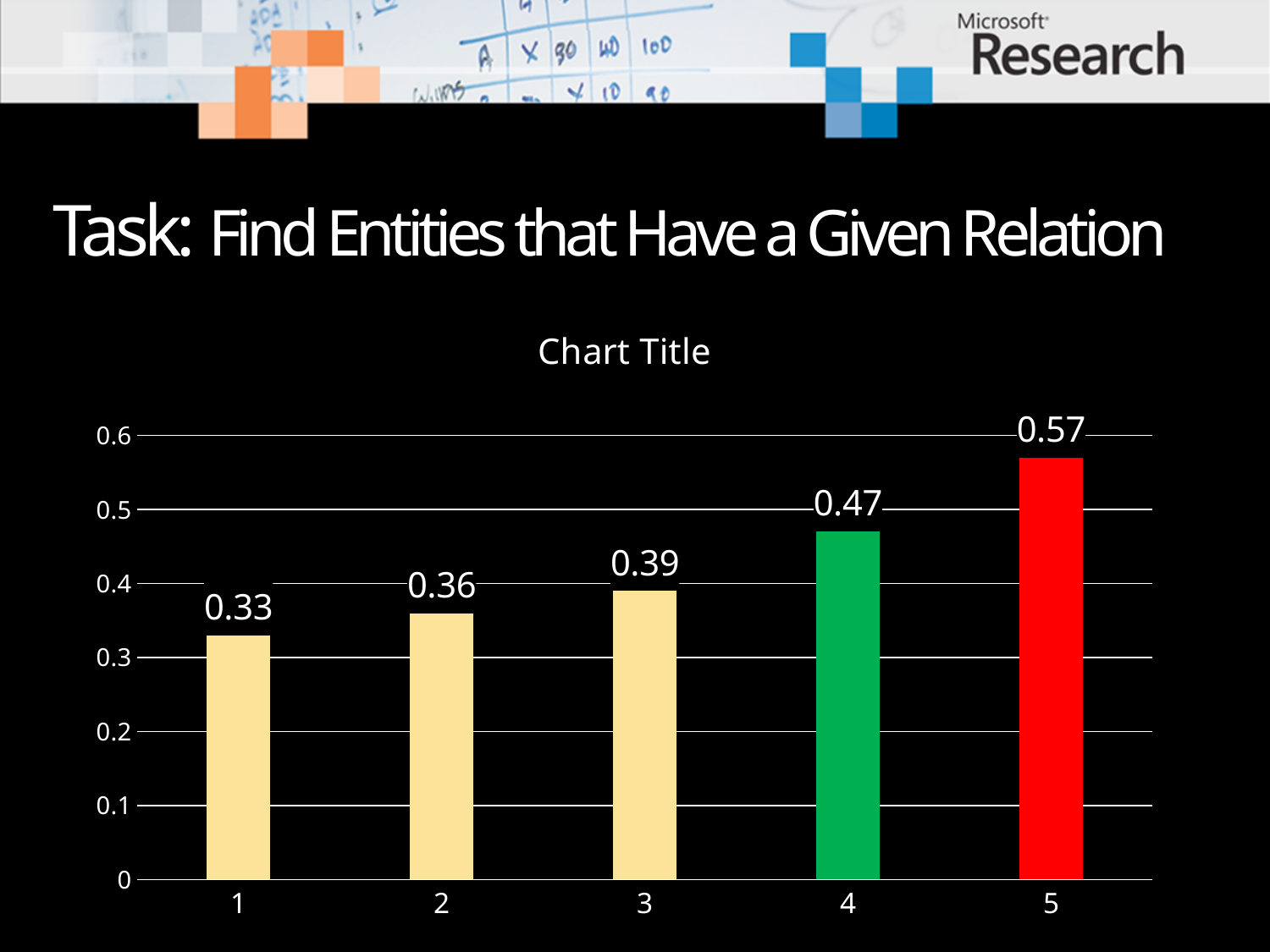
What is the value for category 4? 0.47 How many categories are shown on the x axis? 5 What is the difference between the values for category 5 and category 4? 0.10 What is the value for category 1? 0.33 What is the value for category 5? 0.57 What is the difference between the values for category 3 and category 1? 0.06 Is the value for category 4 greater or less than 0.4? greater Which category has the highest value? 5 Which is larger, the value for category 2 or the value for category 3? 3 Which category has the lowest value? 1 What kind of chart is shown on the slide? bar chart Do the values rise or fall from category 1 to category 5? rise